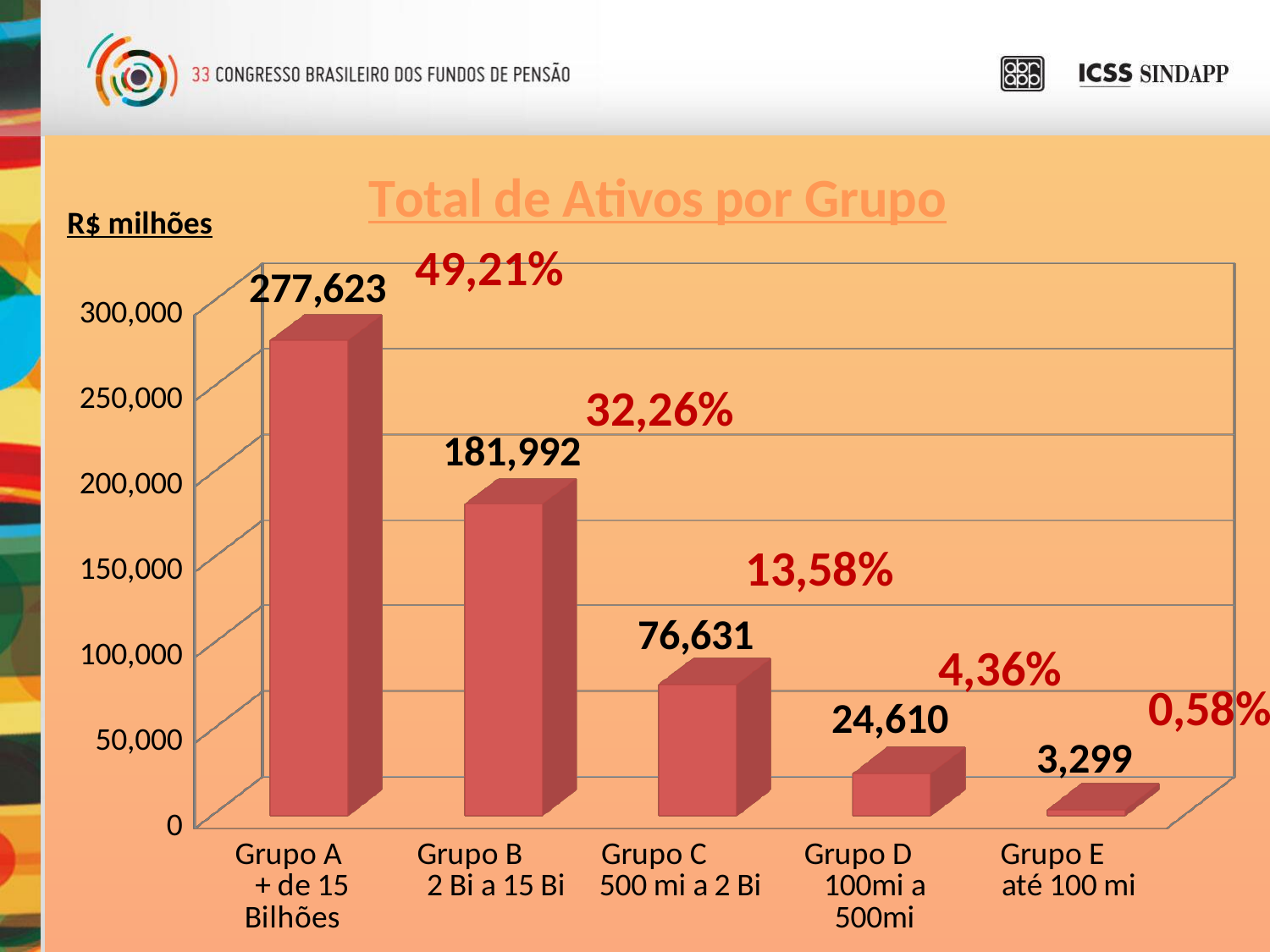
What is the difference between the values for Grupo A and Grupo B? 95,631 What is the value for Grupo C in the chart? 76,631 What is the value for Grupo A in the Total de Ativos por Grupo chart? 277,623 Which group has the lowest total of assets? Grupo E What percentage is shown above the Grupo B bar? 32,26% How many groups are shown on the x axis of the chart? 5 What kind of chart is shown on the slide? Bar chart What percentage is shown for Grupo E? 0,58% Which is larger, the value for Grupo C or the value for Grupo D? Grupo C Which group has the highest total of assets? Grupo A What is the difference between the values for Grupo D and Grupo E? 21,311 Do the values rise or fall from Grupo A to Grupo E? Fall